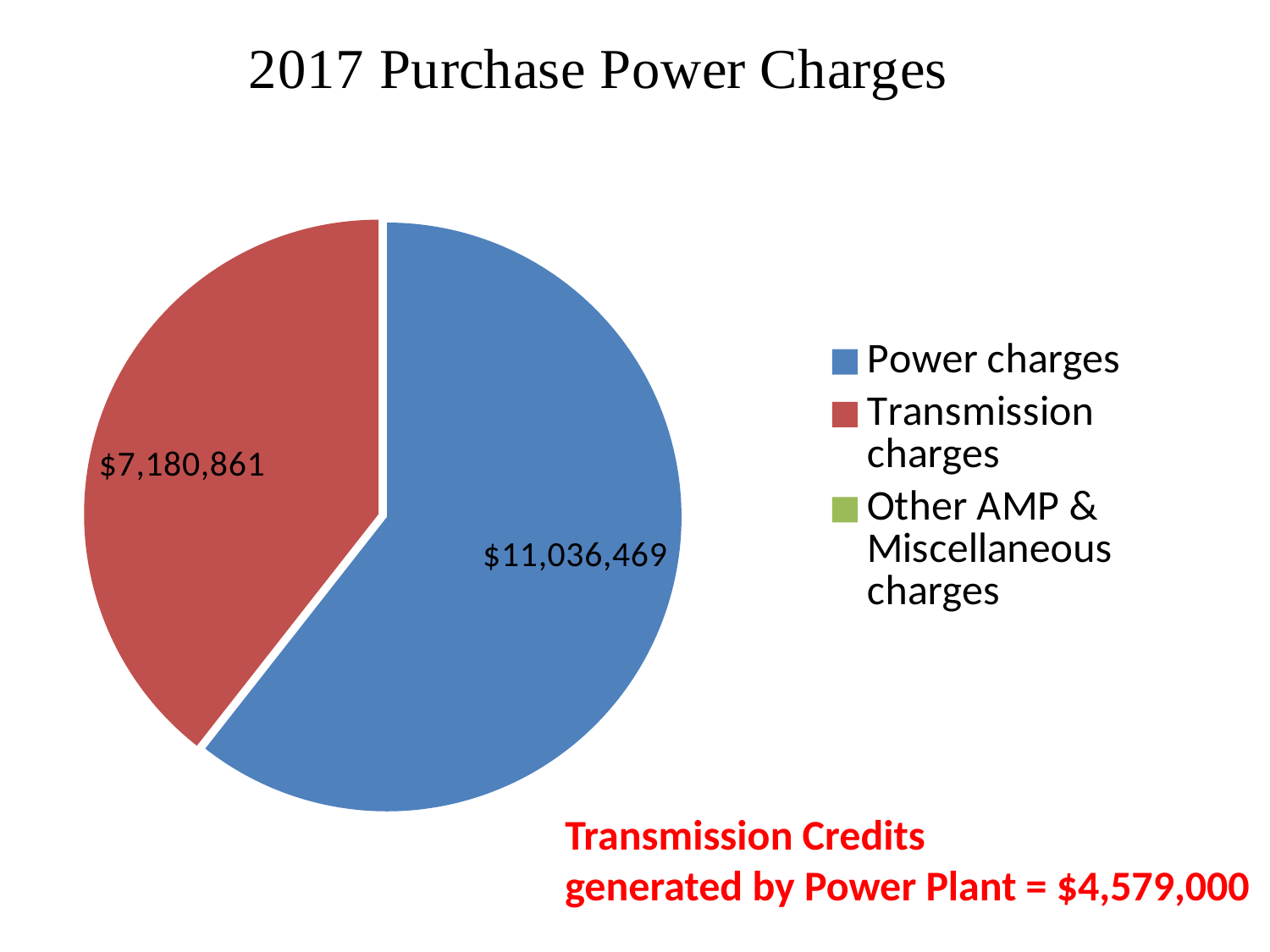
Which legend entry is labelled 'Other AMP & Miscellaneous charges' but has no visible slice in the pie? Other AMP & Miscellaneous charges Which category has the largest slice of the pie? Power charges What colour is the Transmission charges slice? red What is the difference between the Power charges value and the Transmission charges value? $3,855,608 What is the value shown for Power charges? $11,036,469 What is the title of the chart? 2017 Purchase Power Charges What is the value shown for Transmission charges? $7,180,861 How many entries does the legend list? 3 What type of chart is shown on the slide? pie chart Which of the two labelled slices is larger, Power charges or Transmission charges? Power charges